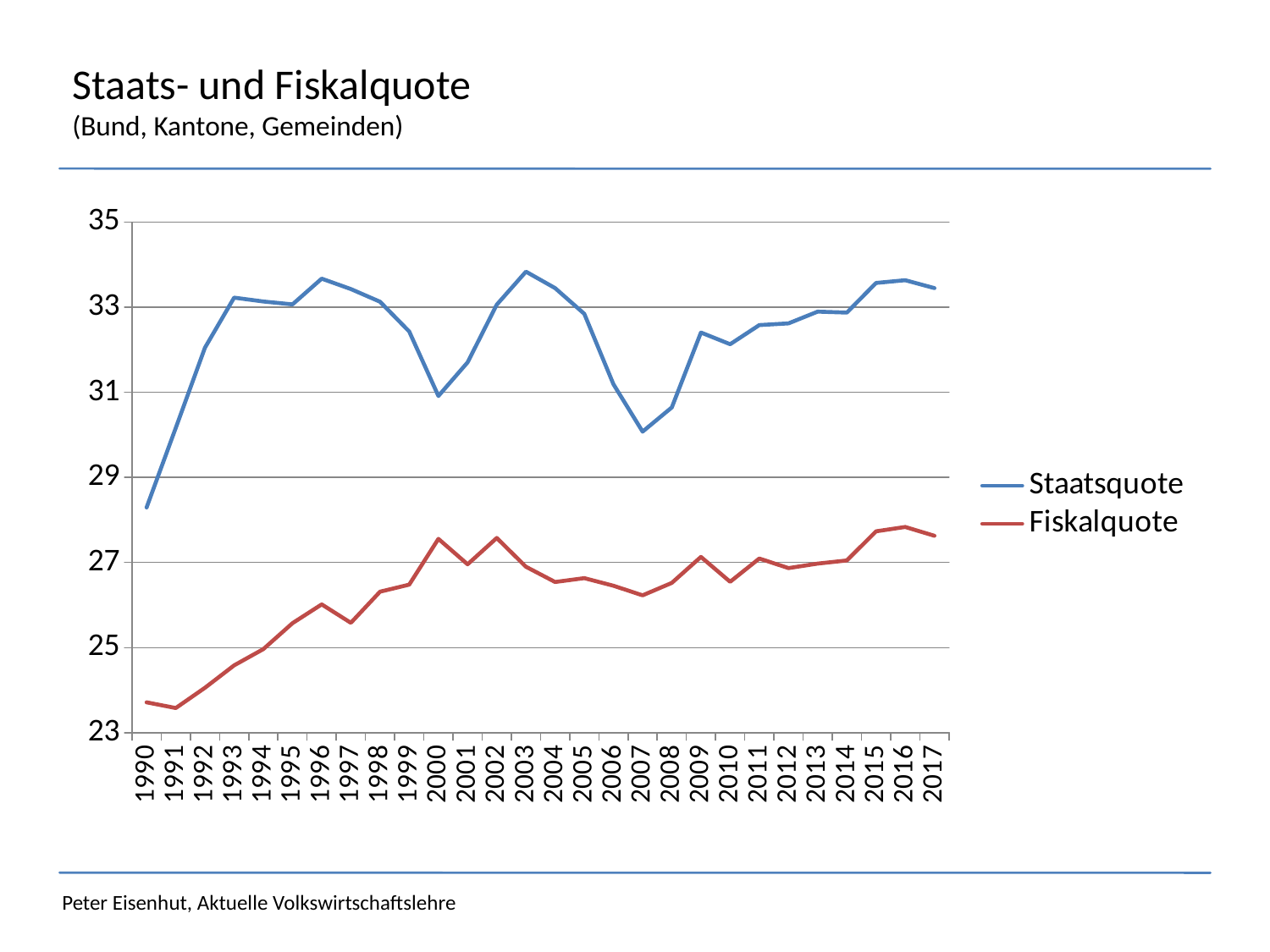
Does the Fiskalquote overall rise or fall from 1990 to 2017? rise How many years are plotted along the x axis? 28 What kind of chart is shown on the slide? line chart Is the Staatsquote value for 1990 greater or less than 29? less In 2000, which series has the larger value, Staatsquote or Fiskalquote? Staatsquote Is the Fiskalquote value for 2016 greater or less than 27? greater How many series does the legend list? 2 What colour is the Staatsquote line? blue In which year is the Staatsquote at its lowest? 1990 Is the Fiskalquote value for 1990 greater or less than 25? less